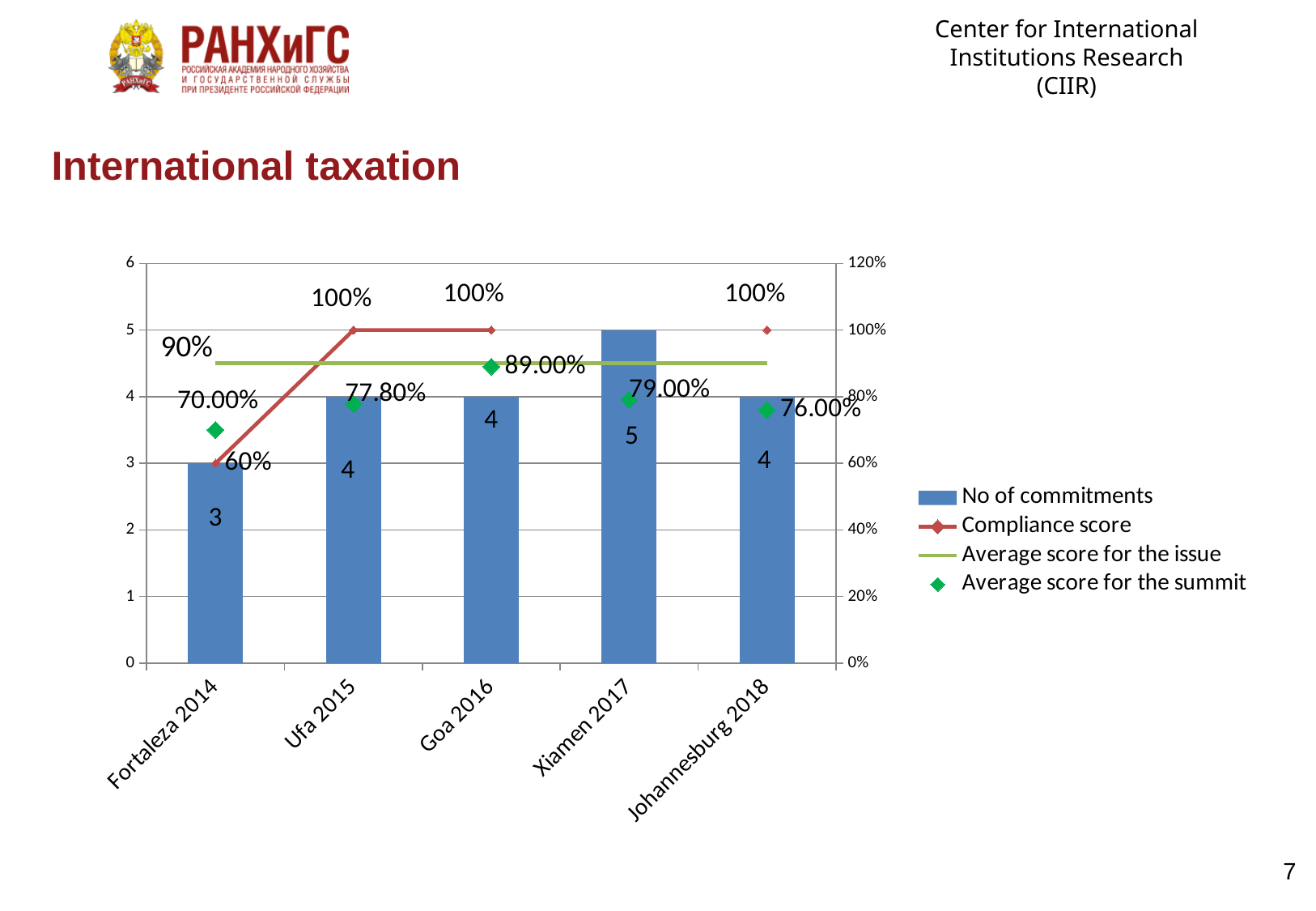
Which summit has the lowest average score for the summit? Fortaleza 2014 Which summit has the highest number of commitments? Xiamen 2017 What is the average score for the issue shown on the chart? 90% What is the average score for the summit at Goa 2016? 89.00% How many series does the legend list? 4 How many more commitments does Xiamen 2017 have than Fortaleza 2014? 2 What is the compliance score for Fortaleza 2014? 60% Which has the higher compliance score, Fortaleza 2014 or Ufa 2015? Ufa 2015 Which summit has the lowest number of commitments? Fortaleza 2014 How many summits are shown on the x axis? 5 How many commitments are shown for Xiamen 2017? 5 Which summit has the highest average score for the summit? Goa 2016